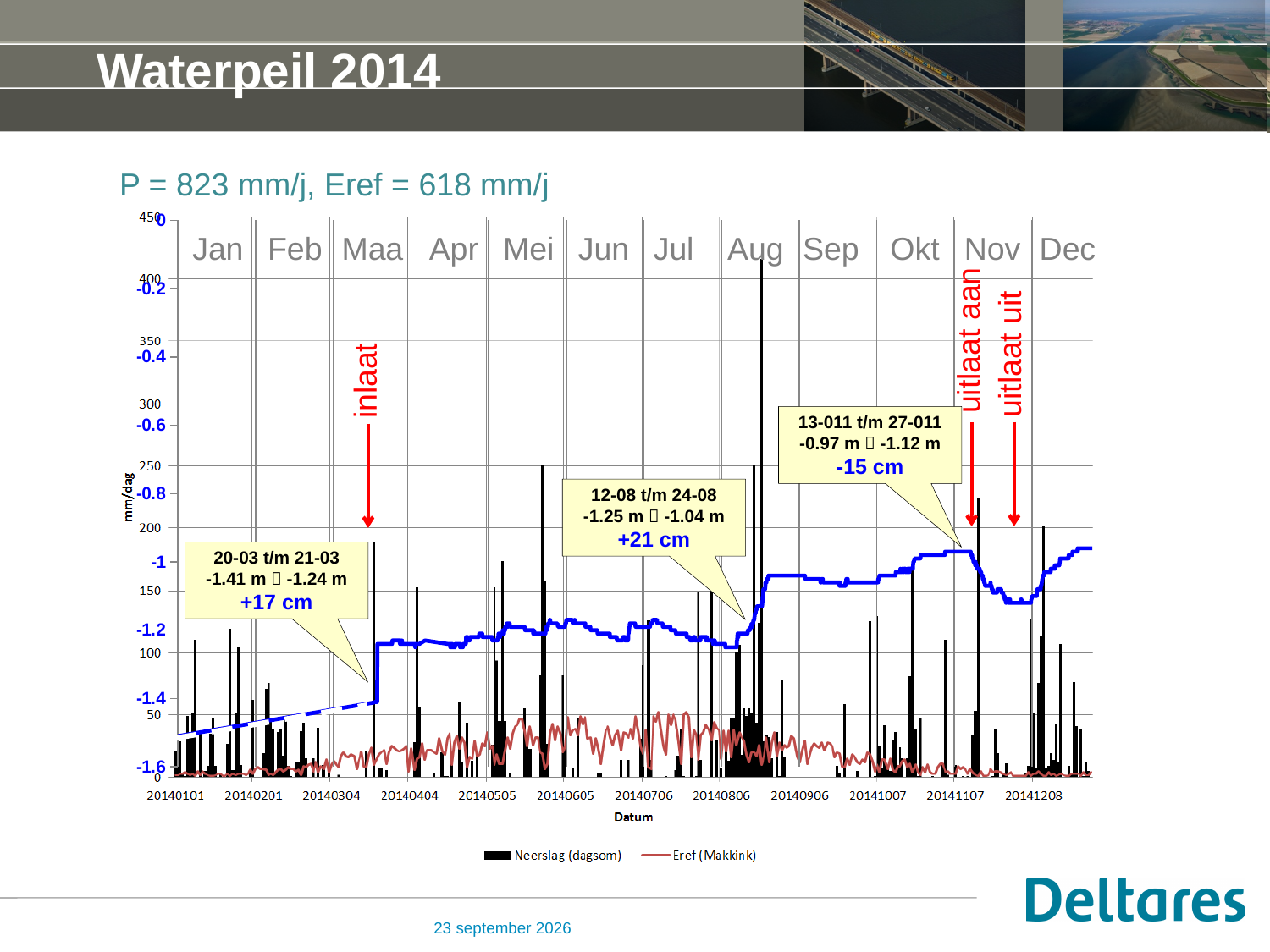
Is the tallest precipitation bar (in August) greater or less than 400 mm/dag? greater Which series is shown as black bars in the chart? Neerslag (dagsom) According to the annotation for 13-011 t/m 27-011, by how many cm did the water level change? -15 cm What is the difference between P (823 mm/j) and Eref (618 mm/j) stated above the chart? 205 mm/j What is the annual precipitation P stated above the chart? 823 mm/j In which month does the tallest precipitation bar occur? Aug How many series does the legend below the chart list? 2 According to the annotation for 12-08 t/m 24-08, from what level to what level did the water level change? -1.25 m to -1.04 m Which annotated period shows the largest water level rise: 20-03 t/m 21-03 (+17 cm) or 12-08 t/m 24-08 (+21 cm)? 12-08 t/m 24-08 According to the annotation for 20-03 t/m 21-03, by how many cm did the water level change? +17 cm What is the label of the x axis of the chart? Datum What is the annual reference evaporation Eref stated above the chart? 618 mm/j